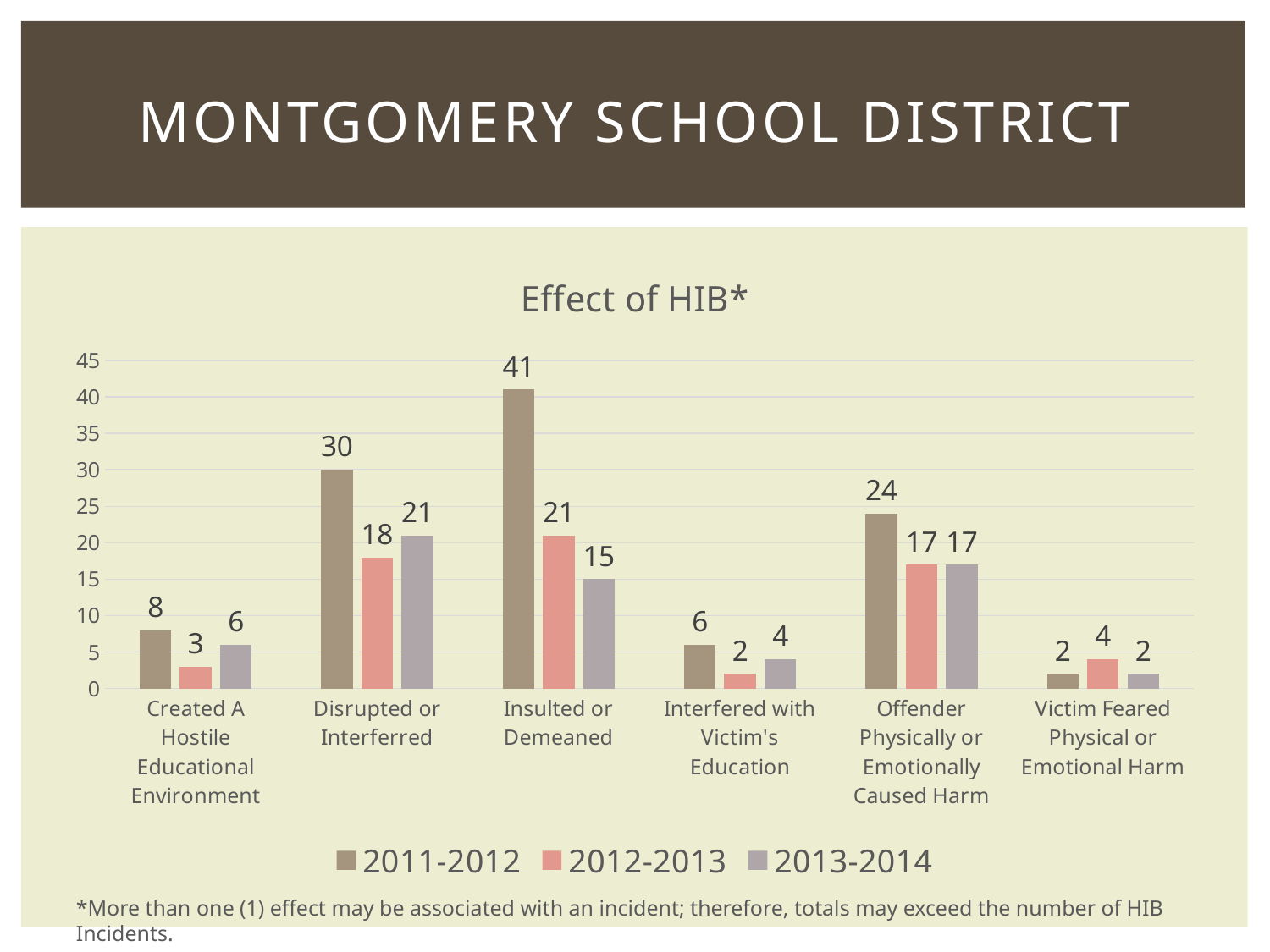
Which category has the highest value in the 2011-2012 series? Insulted or Demeaned Which category has the lowest value in the 2013-2014 series? Victim Feared Physical or Emotional Harm What is the title of the chart? Effect of HIB* What kind of chart is shown on the slide? Bar chart What is the value for Insulted or Demeaned in the 2011-2012 series? 41 What is the difference between the 2011-2012 and 2012-2013 values for Insulted or Demeaned? 20 What is the difference between the 2011-2012 and 2013-2014 values for Offender Physically or Emotionally Caused Harm? 7 How many series does the legend list? 3 How many categories are shown on the x axis? 6 What is the value for Disrupted or Interferred in the 2013-2014 series? 21 What is the value for Interfered with Victim's Education in the 2012-2013 series? 2 Which is larger for Created A Hostile Educational Environment: the 2011-2012 value or the 2013-2014 value? 2011-2012